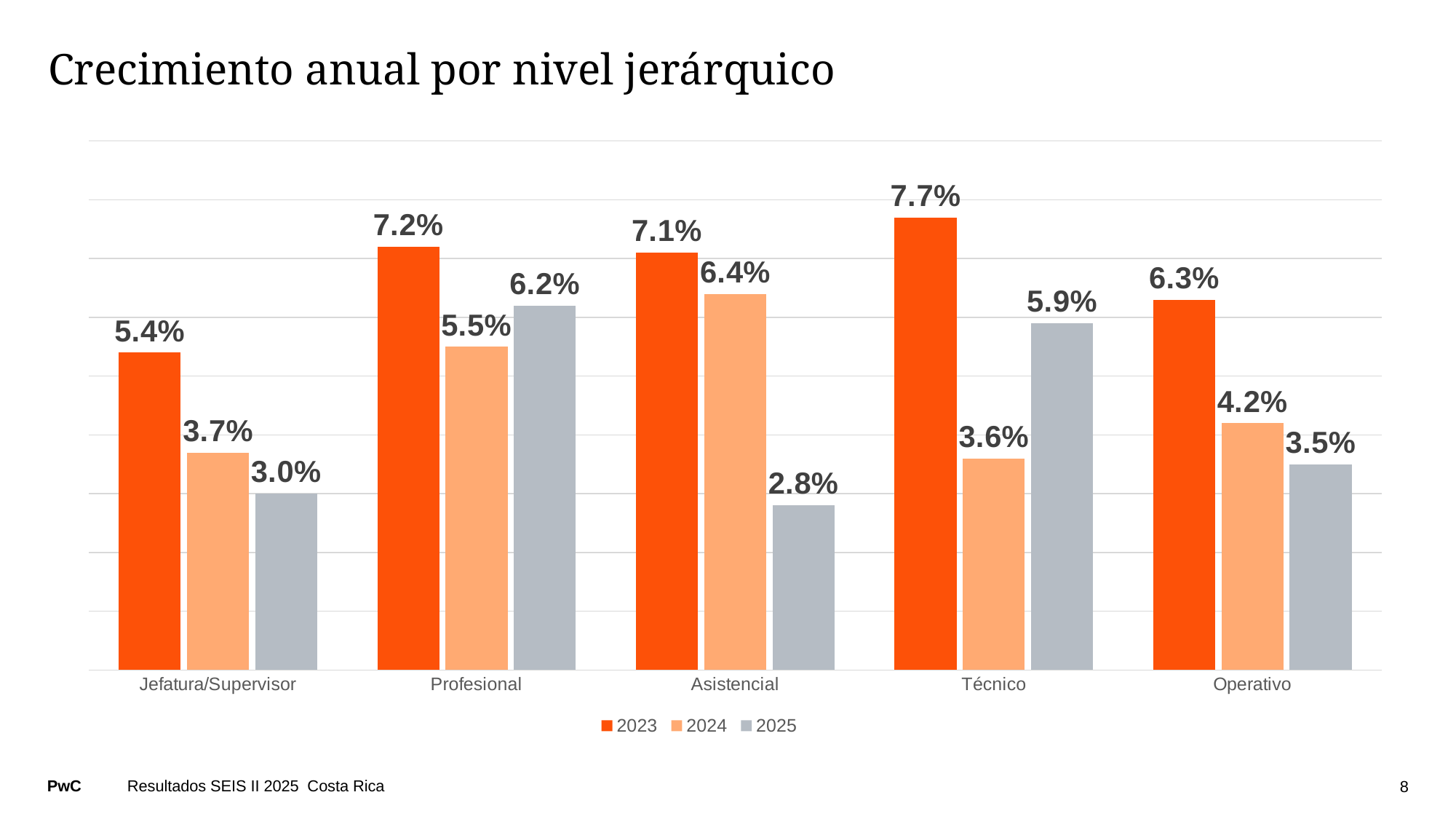
How many series does the legend list? 3 Which colour represents the 2025 series in the legend? Grey Which category has the lowest value in the 2025 series? Asistencial What kind of chart is shown on the slide? Bar chart What is the title of the chart? Crecimiento anual por nivel jerárquico Which category has the highest value in the 2023 series? Técnico What is the difference between the 2023 and 2025 values for Técnico? 1.8% What is the value for Asistencial in 2025? 2.8% Which is larger for Profesional: the 2024 value or the 2025 value? 2025 What is the value for Operativo in 2024? 4.2% How many categories are shown on the x axis? 5 What is the value for Profesional in 2023? 7.2%